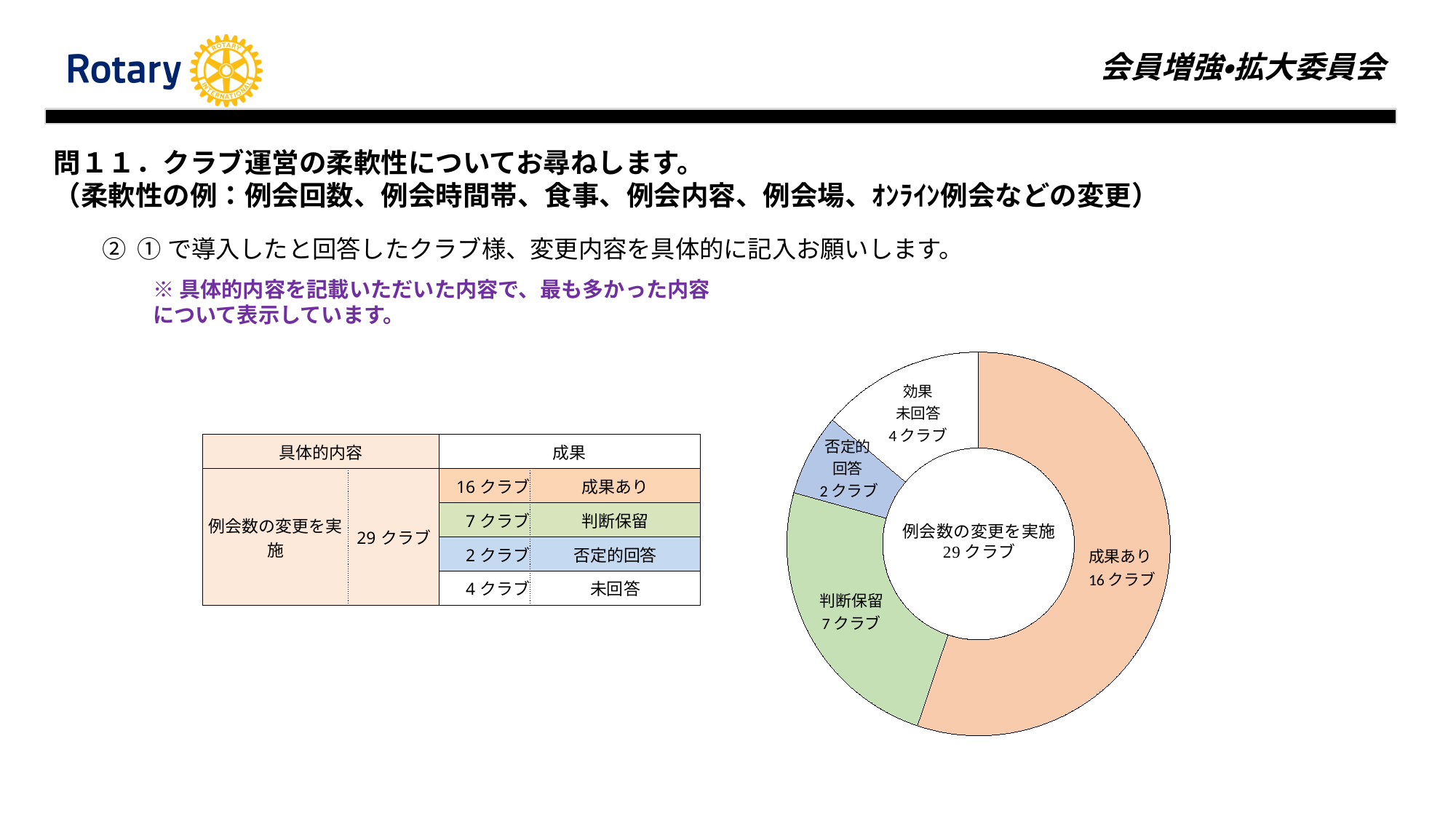
How many clubs are in the 効果未回答 slice of the donut chart? 4 クラブ How many clubs are in the 成果あり slice of the donut chart? 16 クラブ How many clubs are in the 判断保留 slice of the donut chart? 7 クラブ How many clubs are in the 否定的回答 slice of the donut chart? 2 クラブ Which slice has more clubs, 効果未回答 or 否定的回答? 効果未回答 Which slice of the donut chart is the smallest? 否定的回答 What total number of clubs is shown in the centre of the donut chart? 29 クラブ How many slices does the donut chart have? 4 What kind of chart is shown on the slide? Donut (pie) chart What is the difference in clubs between the 成果あり slice and the 判断保留 slice? 9 クラブ What text is shown in the centre of the donut chart? 例会数の変更を実施 29 クラブ Which slice of the donut chart is the largest? 成果あり